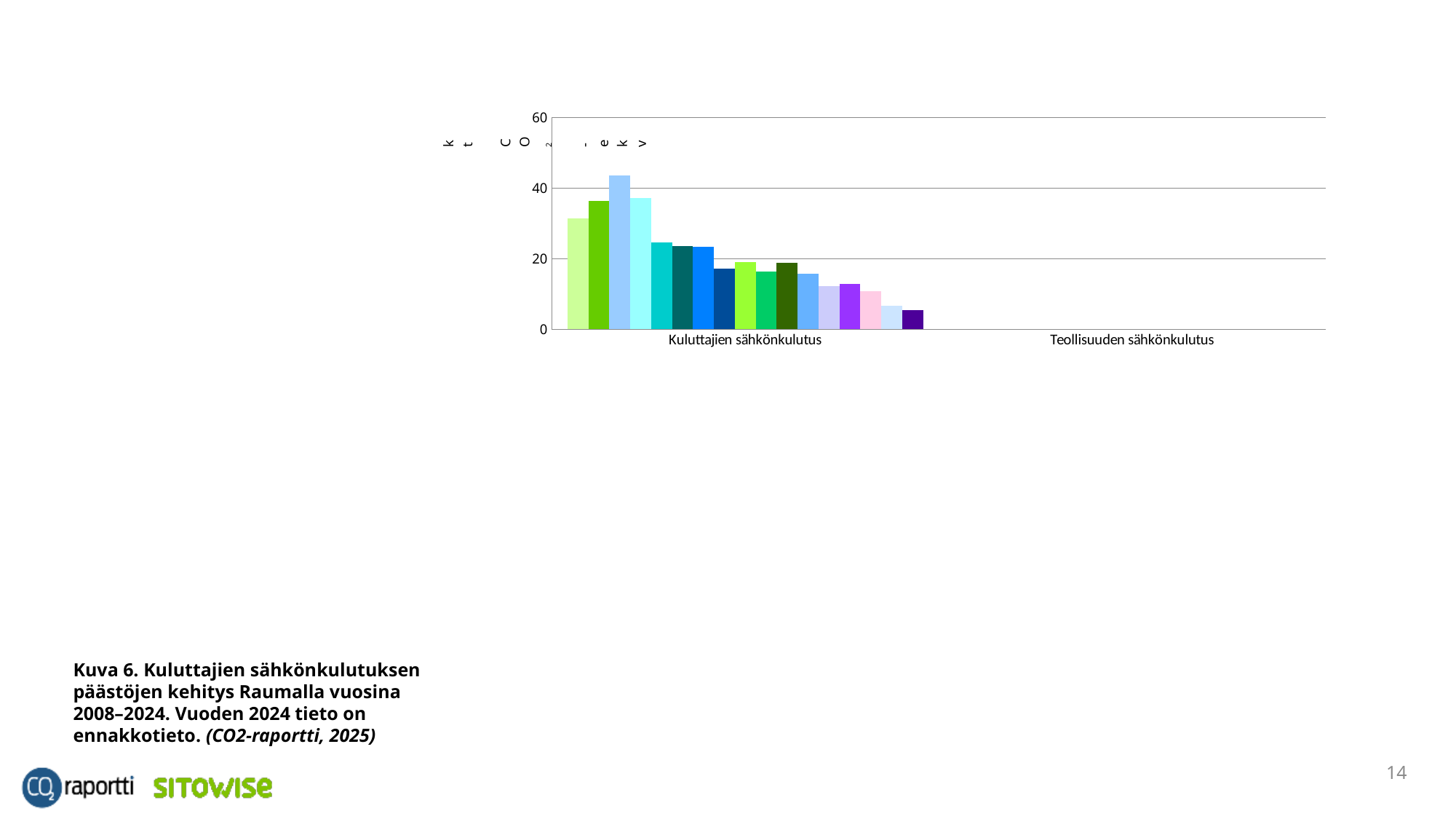
Is the first (leftmost) bar in the Kuluttajien sähkönkulutus group greater or less than 40? less Is the last (rightmost) bar in the Kuluttajien sähkönkulutus group greater or less than 20? less How many categories are labelled on the x axis of the chart? 2 Do the bars in the Kuluttajien sähkönkulutus group generally rise or fall from left to right? fall Which bar in the Kuluttajien sähkönkulutus group is the tallest: the first, the third, or the last? the third Is the first (leftmost) bar in the Kuluttajien sähkönkulutus group greater or less than 20? greater What is the highest value shown on the y axis of the chart? 60 What are the two category labels on the x axis of the chart? Kuluttajien sähkönkulutus and Teollisuuden sähkönkulutus How many bars are plotted in the Kuluttajien sähkönkulutus group? 17 What kind of chart is shown on the slide? bar chart Which is taller in the Kuluttajien sähkönkulutus group: the first bar or the last bar? the first bar